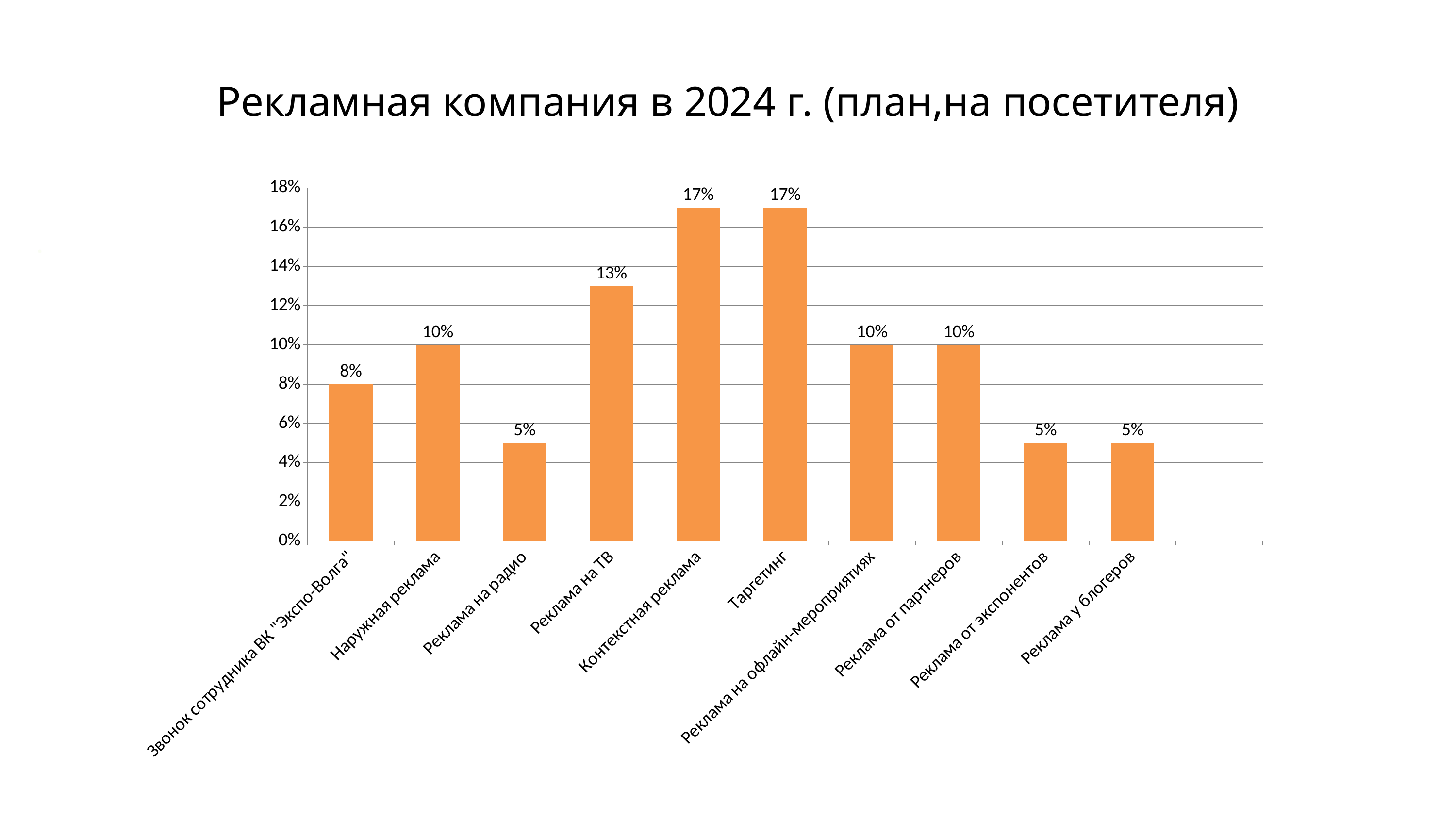
What is the value for Реклама на ТВ? 13% What kind of chart is shown on the slide? bar chart What is the difference between the values for Таргетинг and Наружная реклама? 7% What is the value for Звонок сотрудника ВК "Экспо-Волга"? 8% Is the value for Контекстная реклама greater or less than 14%? greater What is the value for Реклама у блогеров? 5% How many categories are shown on the x axis? 10 Which is larger, the value for Реклама на ТВ or the value for Реклама на офлайн-мероприятиях? Реклама на ТВ What is the lowest value shown on the chart? 5% What is the highest value shown on the chart? 17% What is the title of the chart? Рекламная компания в 2024 г. (план,на посетителя) What is the value for Реклама от партнеров? 10%